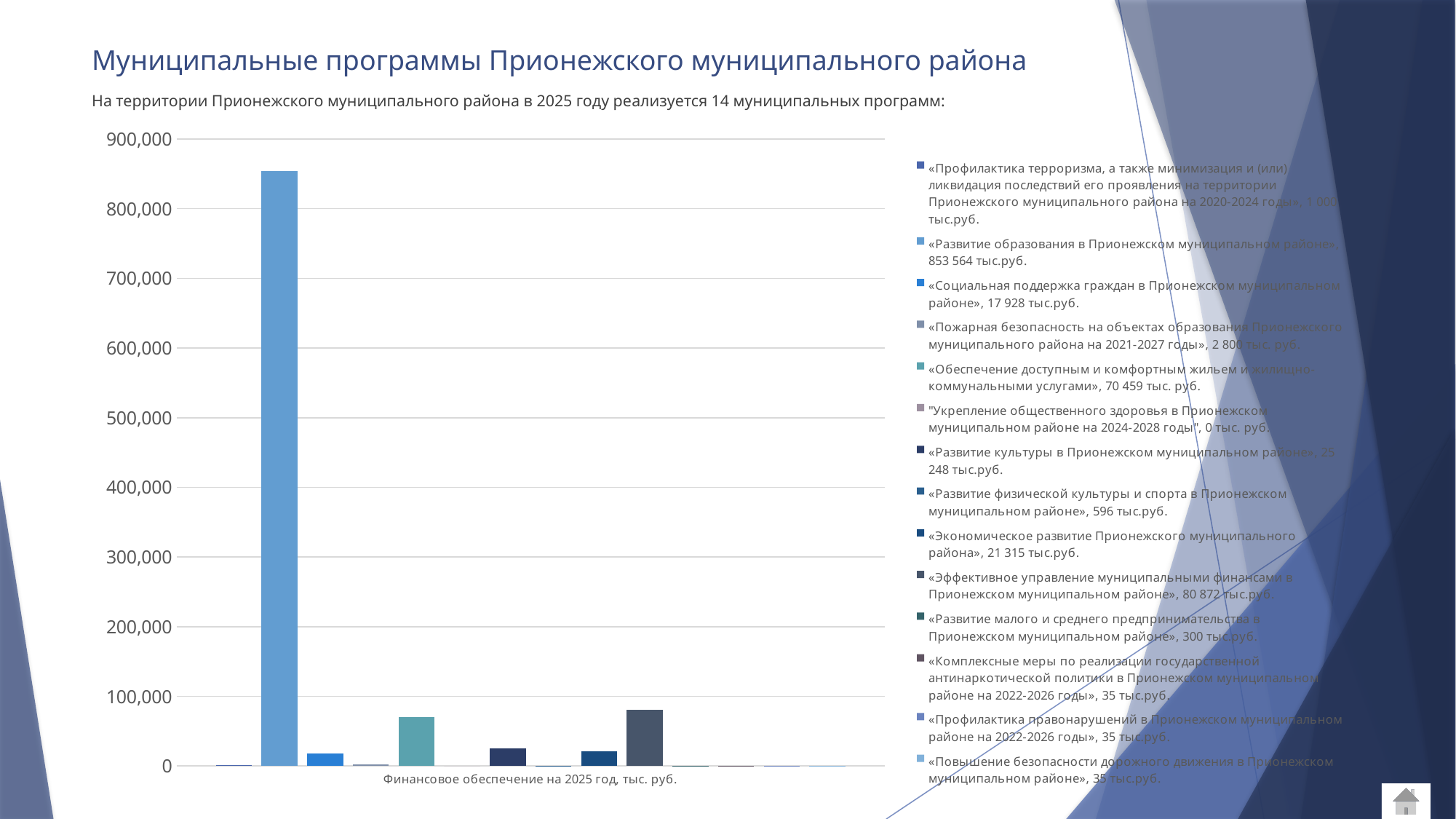
What is the value for «Эффективное управление муниципальными финансами в Прионежском муниципальном районе» according to the legend? 80 872 тыс.руб. What is the label on the x axis of the chart? Финансовое обеспечение на 2025 год, тыс. руб. Which is larger: the bar for «Социальная поддержка граждан в Прионежском муниципальном районе» or the bar for «Обеспечение доступным и комфортным жильем и жилищно-коммунальными услугами»? «Обеспечение доступным и комфортным жильем и жилищно-коммунальными услугами» What is the value for «Социальная поддержка граждан в Прионежском муниципальном районе» according to the legend? 17 928 тыс.руб. How many series does the legend list? 14 What is the difference between the values for «Развитие образования в Прионежском муниципальном районе» and «Эффективное управление муниципальными финансами в Прионежском муниципальном районе»? 772 692 тыс.руб. What kind of chart is shown on the slide? bar chart What is the value for «Развитие образования в Прионежском муниципальном районе» according to the legend? 853 564 тыс.руб. Is the value for «Развитие образования в Прионежском муниципальном районе» greater or less than 800,000? greater Which program has the highest bar? «Развитие образования в Прионежском муниципальном районе» How many categories are shown on the x axis? 1 Is the value for «Эффективное управление муниципальными финансами в Прионежском муниципальном районе» greater or less than 100,000? less